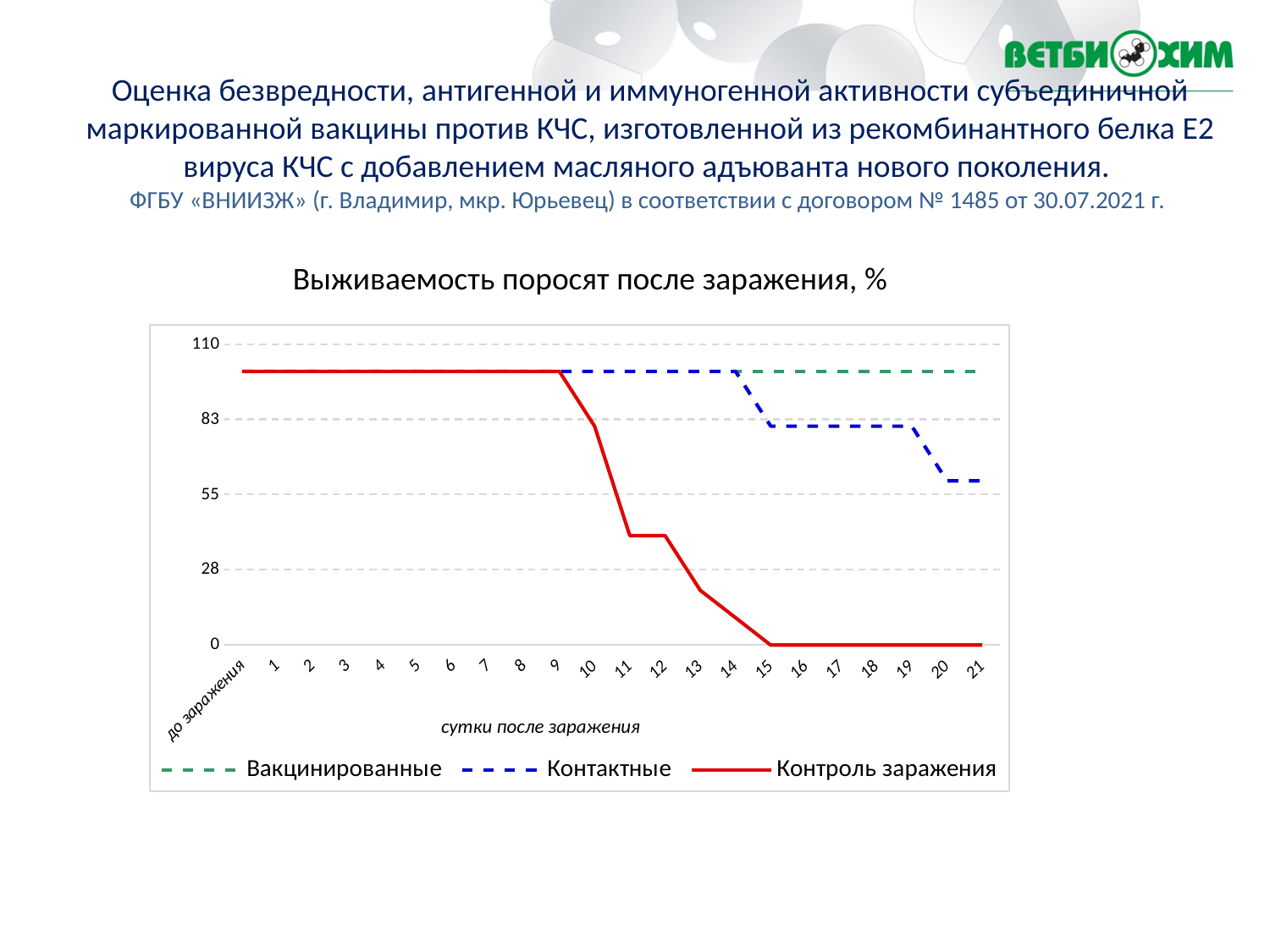
How many points are plotted along the x axis (including 'до заражения')? 22 Is the value for Вакцинированные on day 21 greater or less than 83? greater On day 12, which series has the higher value, Контактные or Контроль заражения? Контактные How many series does the legend list? 3 Which series has the lowest value on day 21? Контроль заражения Is the value for Контроль заражения on day 13 greater or less than 28? less What is the value for Контроль заражения on day 21? 0 What is the title of the chart? Выживаемость поросят после заражения, % What kind of chart is shown on the slide? line chart Do the values for Контроль заражения rise or fall along the x axis? fall Is the value for Контактные on day 16 greater or less than 55? greater